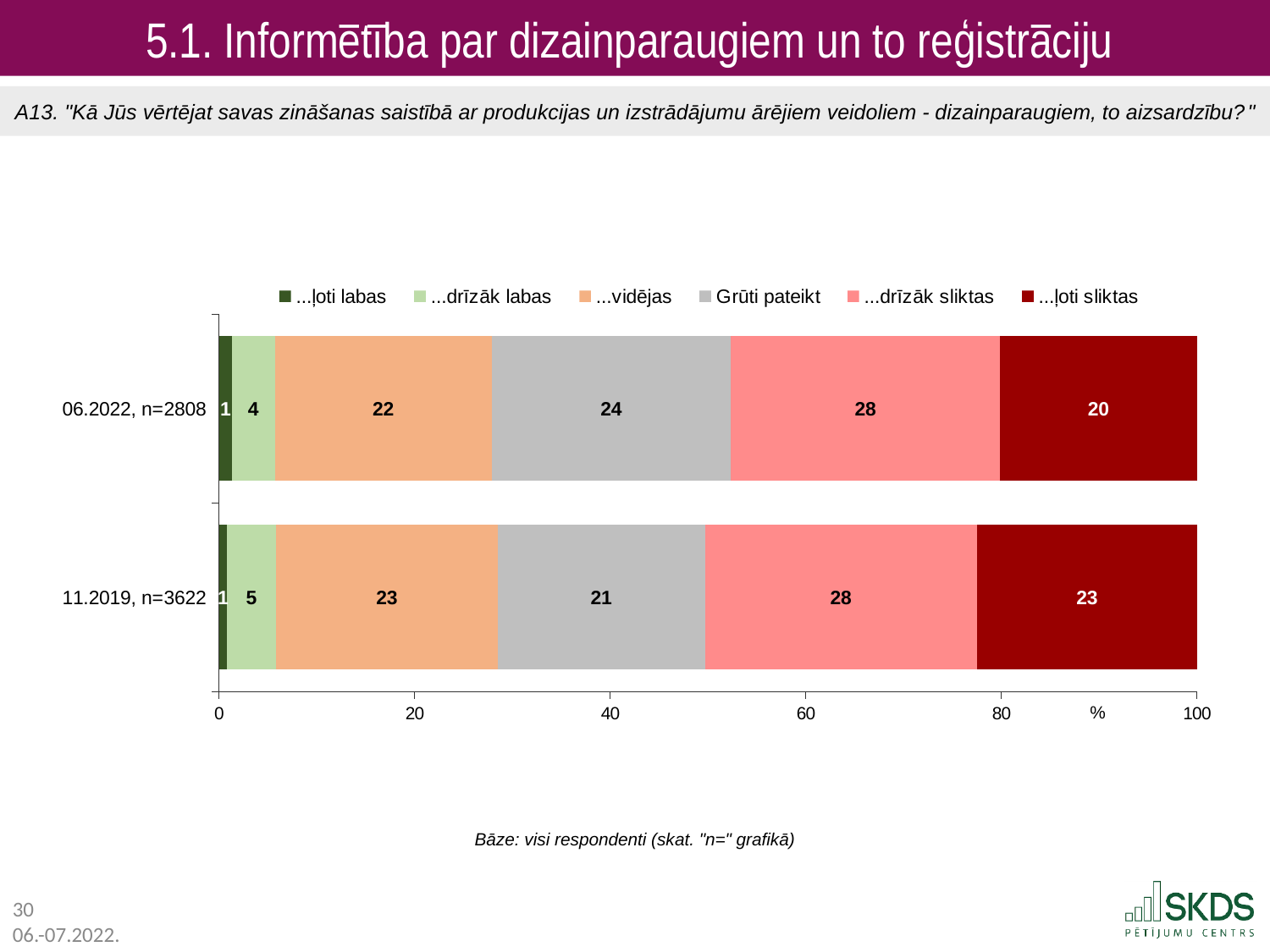
What is the difference between the "...ļoti sliktas" values for 11.2019, n=3622 and 06.2022, n=2808? 3 What is the value for "...ļoti sliktas" in the 06.2022, n=2808 bar? 20 How many categories (bars) are plotted in the chart? 2 What is the value for "Grūti pateikt" in the 11.2019, n=3622 bar? 21 What is the total of the 06.2022, n=2808 stacked bar? 99 What is the value for "...vidējas" in the 06.2022, n=2808 bar? 22 How many series does the legend list? 6 Which series has the lowest value in the 11.2019, n=3622 bar? ...ļoti labas What is the value for "...drīzāk labas" in the 11.2019, n=3622 bar? 5 Which series has the highest value in the 06.2022, n=2808 bar? ...drīzāk sliktas Which is larger: the "Grūti pateikt" value for 06.2022, n=2808 or for 11.2019, n=3622? 06.2022, n=2808 What kind of chart is shown on the slide? stacked bar chart